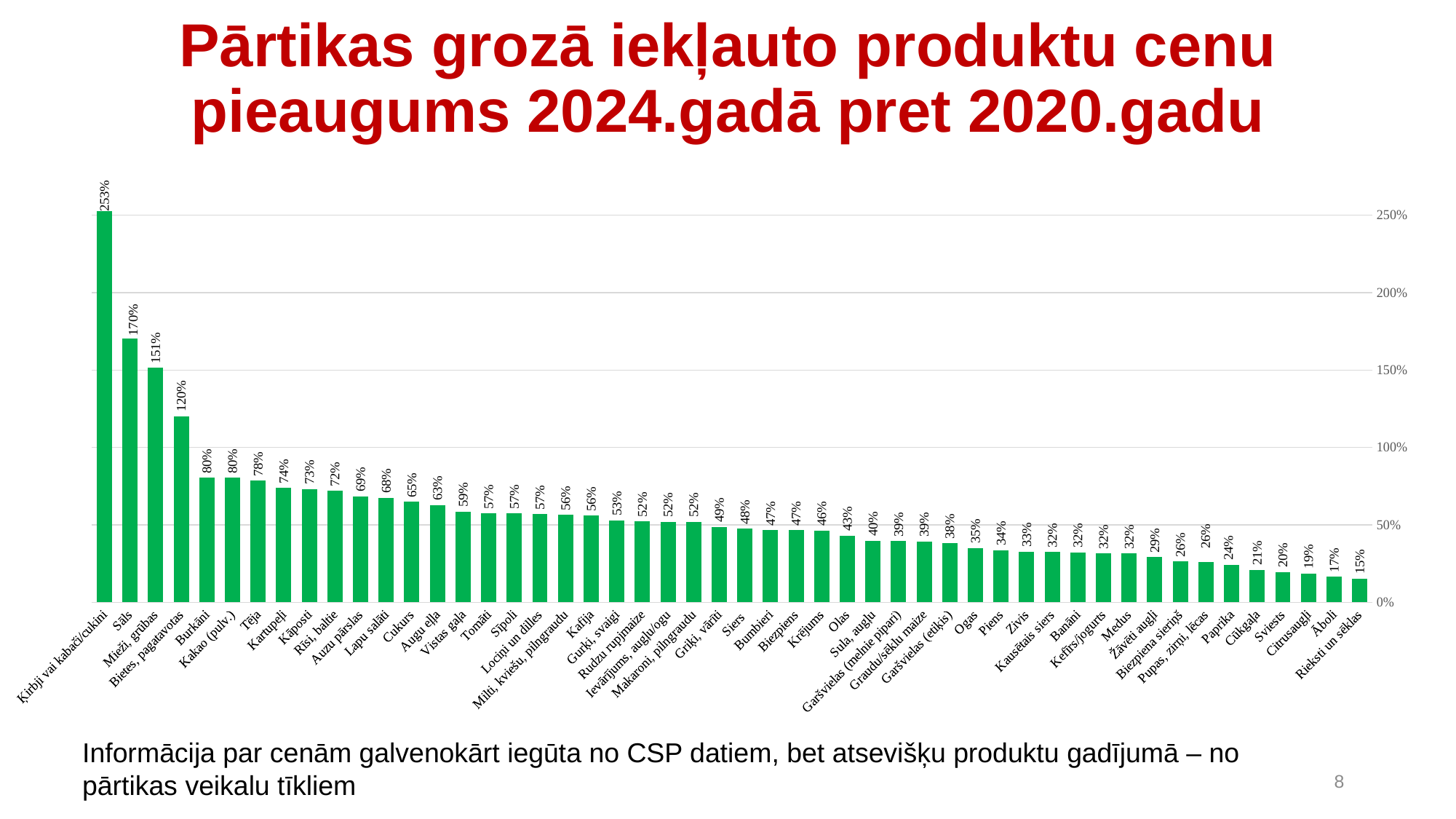
What is the price increase shown for Sāls? 170% Which has a larger value, Cukurs or Siers? Cukurs Is the value for Bietes, pagatavotas greater or less than 100%? greater Which product has the highest price increase? Ķirbji vai kabači/cukini How many products are shown in the chart? 50 What kind of chart is shown on the slide? Bar chart What is the value shown for Kartupeļi? 74% What is the value shown for Piens? 34% Do the values rise or fall from left to right along the x axis? Fall What is the difference between the values for Ķirbji vai kabači/cukini and Sāls? 83% Which product has the lowest price increase? Rieksti un sēklas What is the difference between the values for Olas and Sviests? 23%